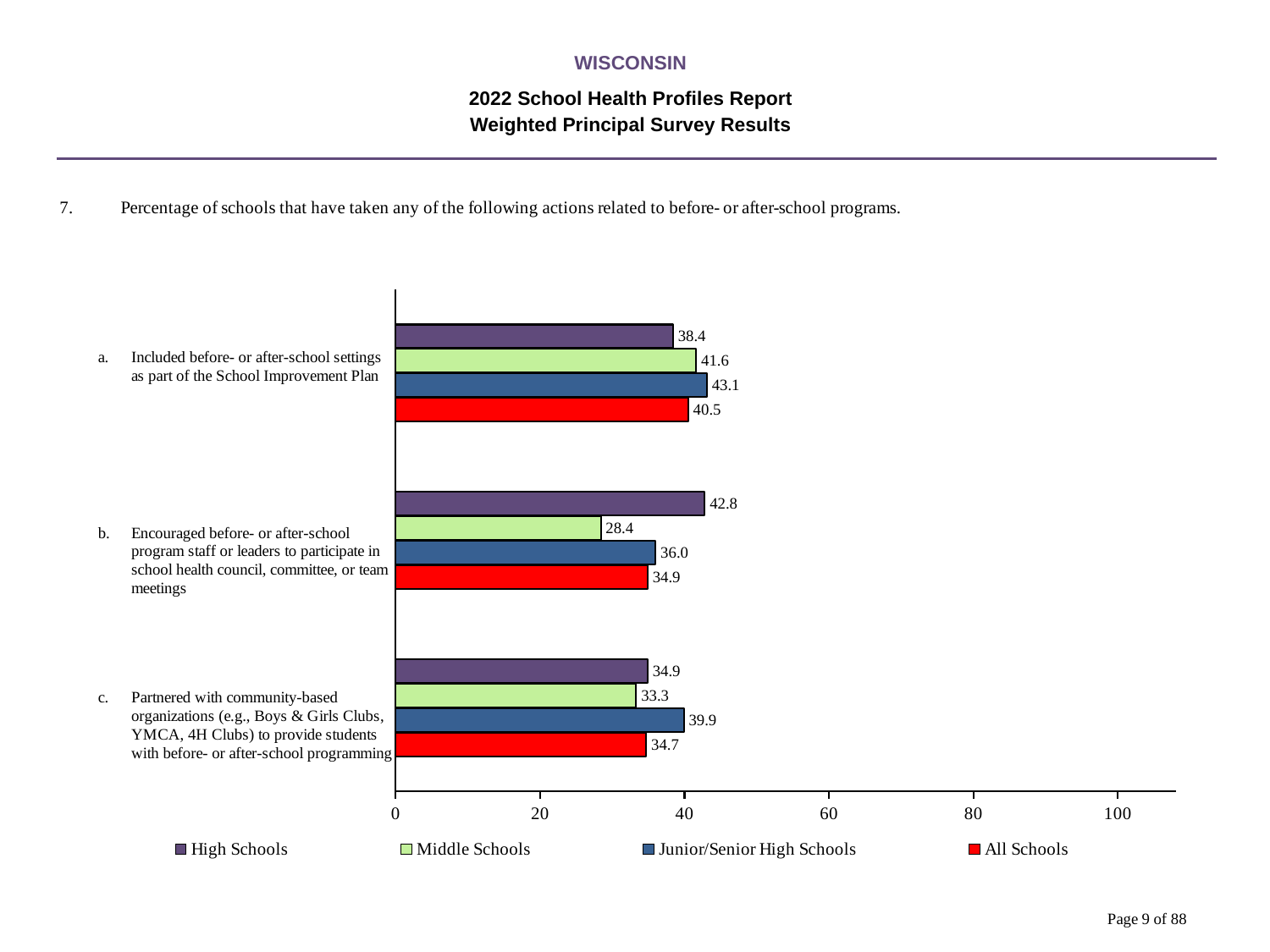
What is the value for All Schools for item c, 'Partnered with community-based organizations to provide students with before- or after-school programming'? 34.7 What colour represents All Schools in the legend? red What is the value for Junior/Senior High Schools for item a, 'Included before- or after-school settings as part of the School Improvement Plan'? 43.1 What is the value for Middle Schools for item b, 'Encouraged before- or after-school program staff or leaders to participate in school health council, committee, or team meetings'? 28.4 How many action items (categories) are shown on the chart? 3 Which school type has the lowest value for item c, 'Partnered with community-based organizations to provide students with before- or after-school programming'? Middle Schools What is the difference between the High Schools and Middle Schools values for item b, 'Encouraged before- or after-school program staff or leaders to participate in school health council, committee, or team meetings'? 14.4 For item a, 'Included before- or after-school settings as part of the School Improvement Plan', which is larger: the High Schools value or the Middle Schools value? Middle Schools How many series does the legend list? 4 What kind of chart is shown on the slide? bar chart Is the Junior/Senior High Schools value for item c, 'Partnered with community-based organizations to provide students with before- or after-school programming', greater or less than 60? less Which school type has the highest value for item b, 'Encouraged before- or after-school program staff or leaders to participate in school health council, committee, or team meetings'? High Schools